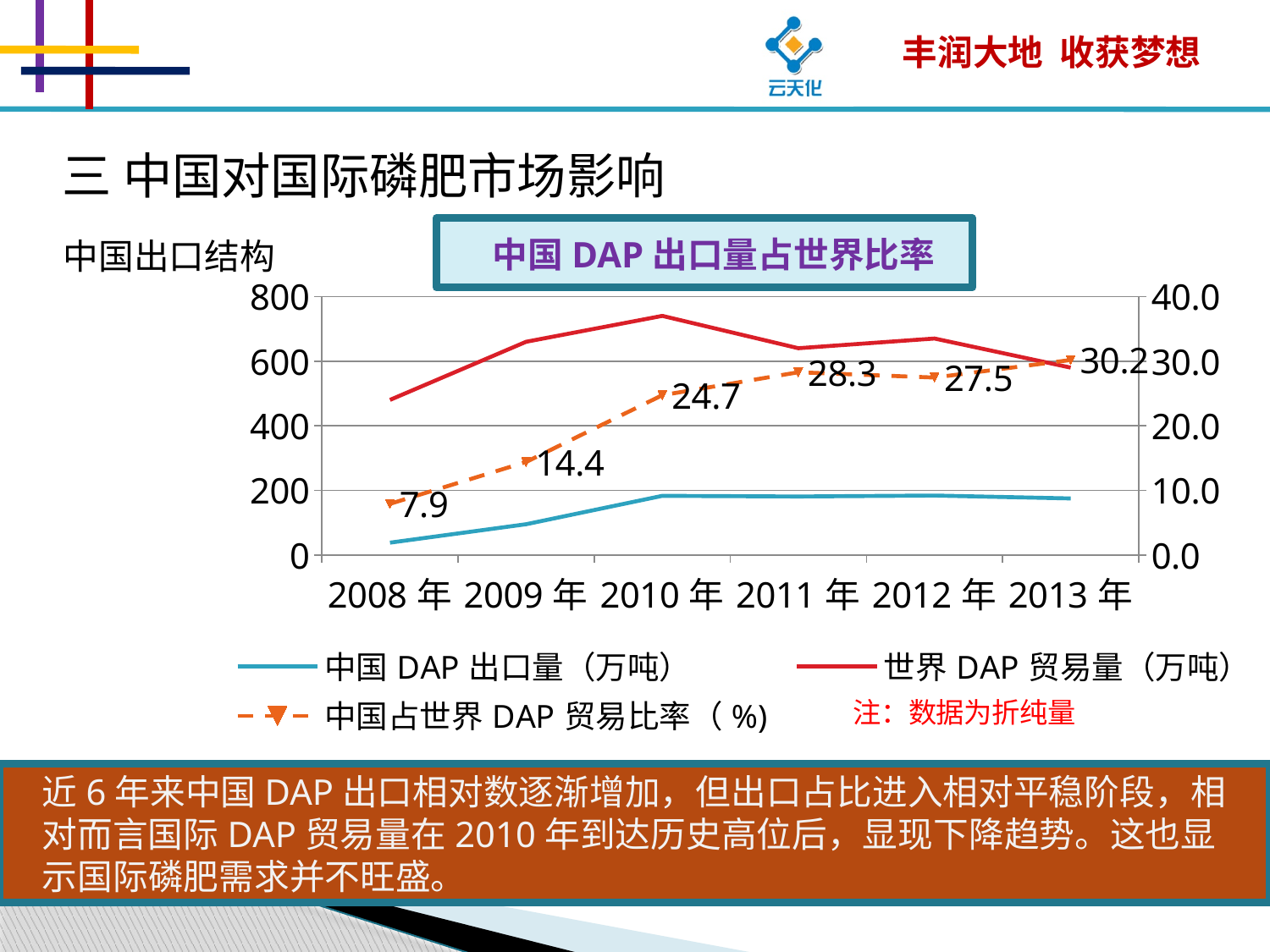
What is the difference between the 中国占世界 DAP 贸易比率（%）values for 2013 年 and 2008 年? 22.3 In which year does 世界 DAP 贸易量（万吨）reach its highest value? 2010 年 How many series does the chart legend list? 3 Is the value of 中国 DAP 出口量（万吨）in 2008 年 greater or less than 200? less In which year is 中国占世界 DAP 贸易比率（%）the highest? 2013 年 What is the value of 中国占世界 DAP 贸易比率（%）in 2013 年? 30.2 What is the value of 中国占世界 DAP 贸易比率（%）in 2008 年? 7.9 How many years are shown on the x axis of the chart? 6 In which year is 中国占世界 DAP 贸易比率（%）the lowest? 2008 年 Which year has a larger 中国占世界 DAP 贸易比率（%）value, 2011 年 or 2012 年? 2011 年 Is the value of 世界 DAP 贸易量（万吨）in 2010 年 greater or less than 600? greater What is the value of 中国占世界 DAP 贸易比率（%）in 2011 年? 28.3